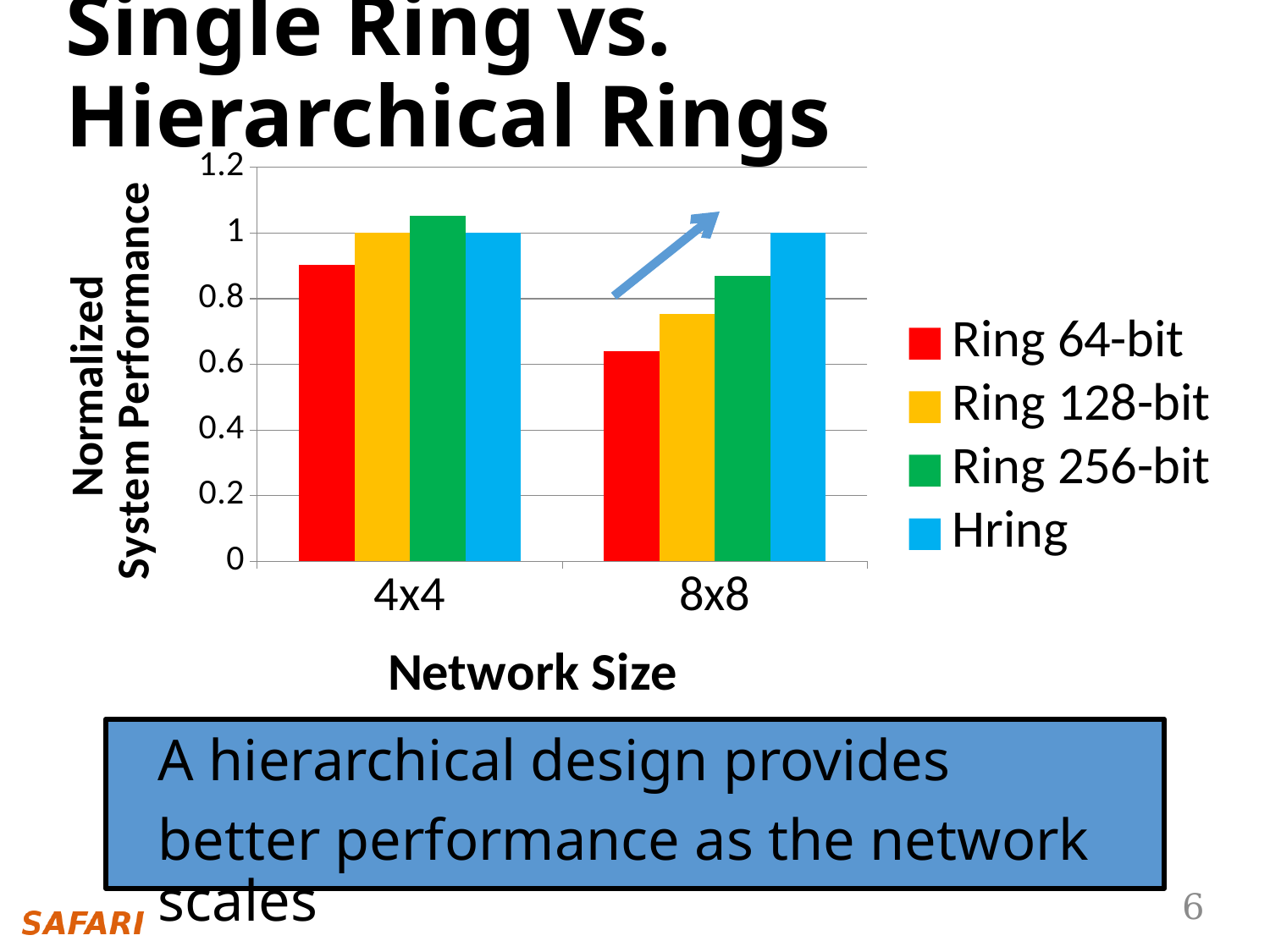
What kind of chart is shown on the slide? bar chart Is the value for Ring 64-bit at 8x8 greater or less than 0.8? less Which series has the lowest normalized system performance at network size 8x8? Ring 64-bit How many series does the legend list? 4 Which is larger: Ring 128-bit at 4x4 or Ring 128-bit at 8x8? Ring 128-bit at 4x4 What is the normalized system performance of Hring at network size 8x8? 1 What is the normalized system performance of Hring at network size 4x4? 1 Which series has the highest normalized system performance at network size 4x4? Ring 256-bit Is the value for Ring 256-bit at 4x4 greater or less than 1? greater Does the normalized system performance of Ring 64-bit rise or fall from 4x4 to 8x8? fall How many network sizes are shown on the x axis? 2 Which series has the highest normalized system performance at network size 8x8? Hring